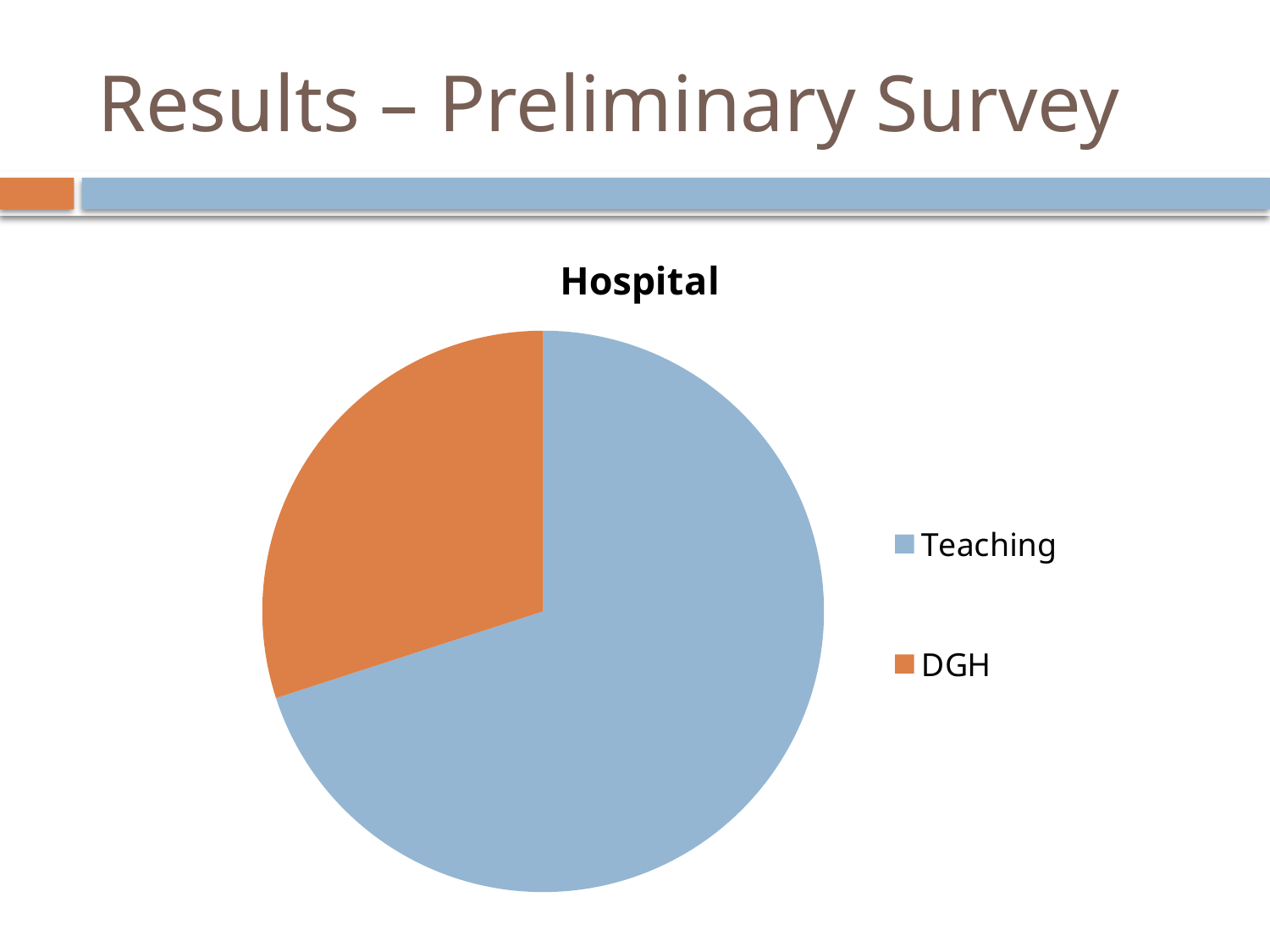
How many slices does the pie chart have? 2 What kind of chart is shown on the slide? pie chart Which slice is larger, Teaching or DGH? Teaching What is the title of the chart? Hospital Which category has the largest slice of the pie? Teaching Which category has the smallest slice of the pie? DGH What colour is the Teaching slice? blue How many entries does the legend list? 2 Is the DGH slice more or less than half of the pie? less Is the Teaching slice more or less than half of the pie? more